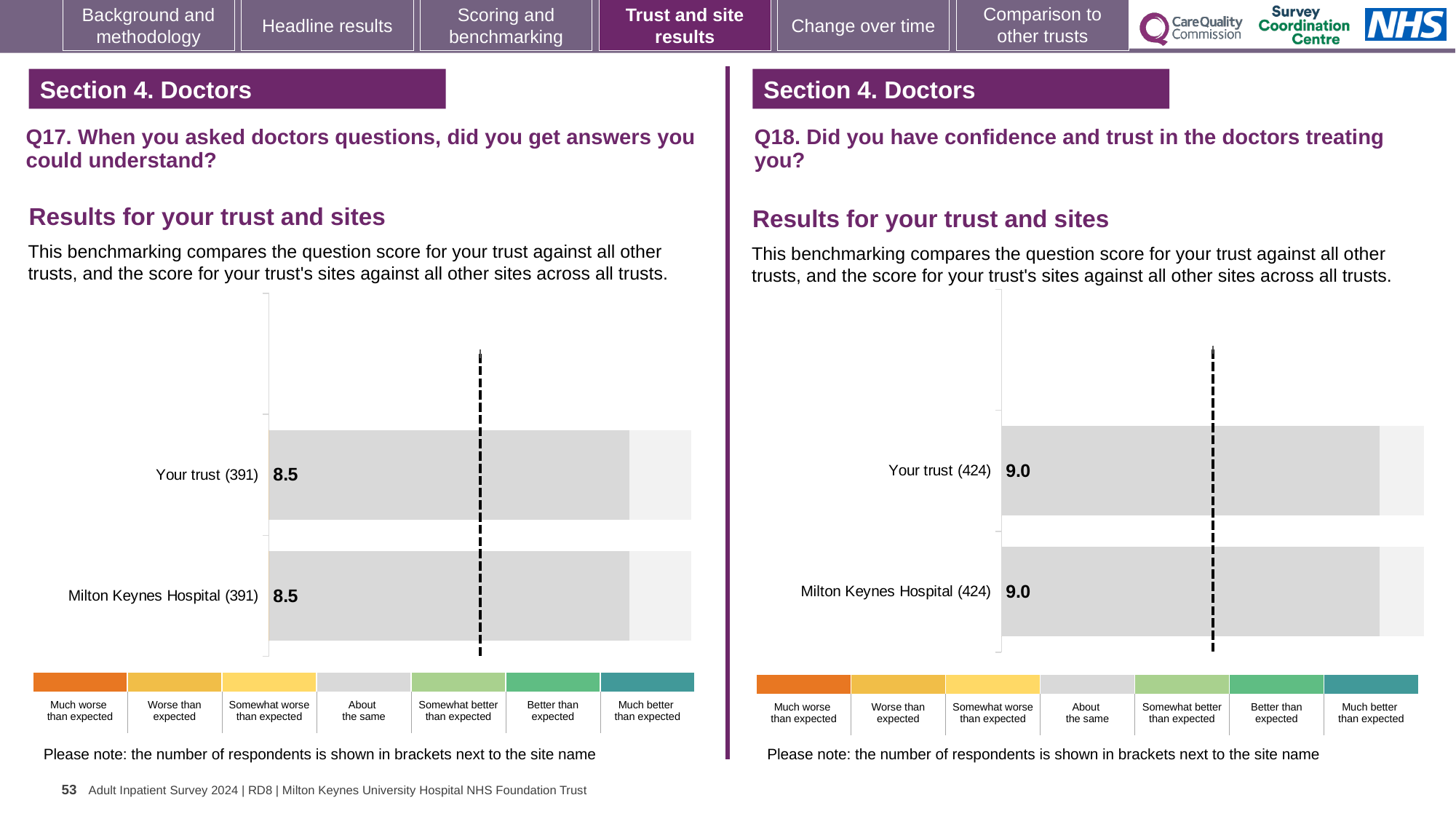
On the Q17 chart (left), what is the score for Your trust? 8.5 How many bars are plotted on the Q18 chart (right)? 2 On the Q17 chart (left), how many respondents are shown in brackets next to Your trust? 391 On the Q17 chart (left), what is the difference between the score for Your trust and the score for Milton Keynes Hospital? 0.0 Is the score for Your trust on the Q18 chart (right) larger or smaller than the score for Your trust on the Q17 chart (left)? Larger On the Q18 chart (right), what is the score for Your trust? 9.0 On the Q18 chart (right), what is the difference between the score for Your trust and the score for Milton Keynes Hospital? 0.0 How many bars are plotted on the Q17 chart (left)? 2 On the Q18 chart (right), how many respondents are shown in brackets next to Milton Keynes Hospital? 424 On the Q18 chart (right), what is the score for Milton Keynes Hospital? 9.0 On the Q17 chart (left), what is the score for Milton Keynes Hospital? 8.5 What kind of chart is used on the Q17 chart (left)? Bar chart